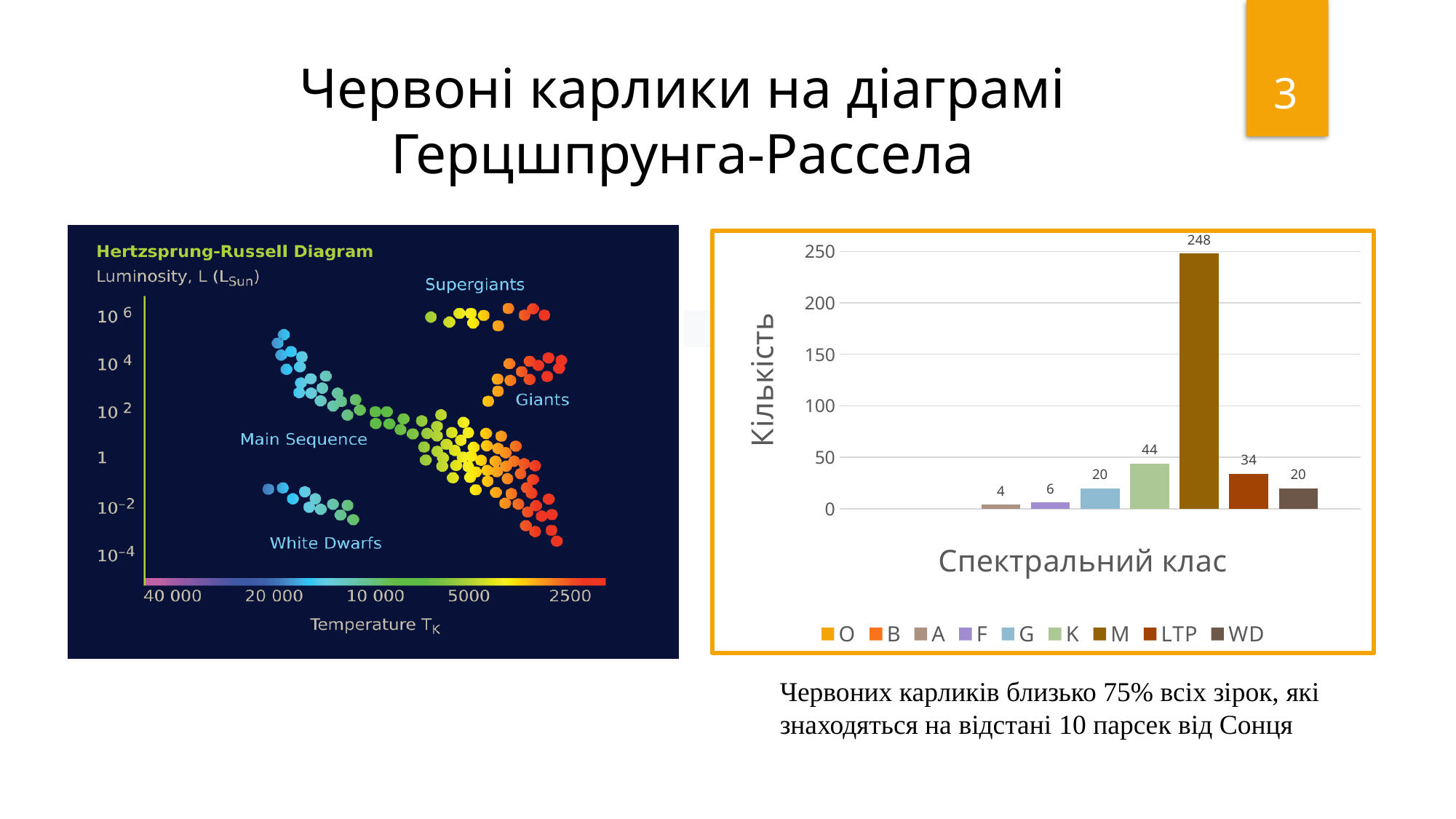
In the bar chart on the right, is the value for M greater or less than 200? greater How many entries does the legend of the bar chart on the right list? 9 In the bar chart on the right, what is the difference between the values for M and K? 204 In the bar chart on the right (Спектральний клас), what is the value for spectral class M? 248 In the bar chart on the right, which spectral class has the highest value? M What is the y-axis label of the bar chart on the right? Кількість In the bar chart on the right, which labelled bar has the lowest value? A In the bar chart on the right, what is the value for spectral class K? 44 In the bar chart on the right, which is larger, the value for LTP or the value for WD? LTP What kind of chart is the chart on the right of the slide? bar chart In the bar chart on the right, what is the value for LTP? 34 In the bar chart on the right, what is the value for spectral class A? 4